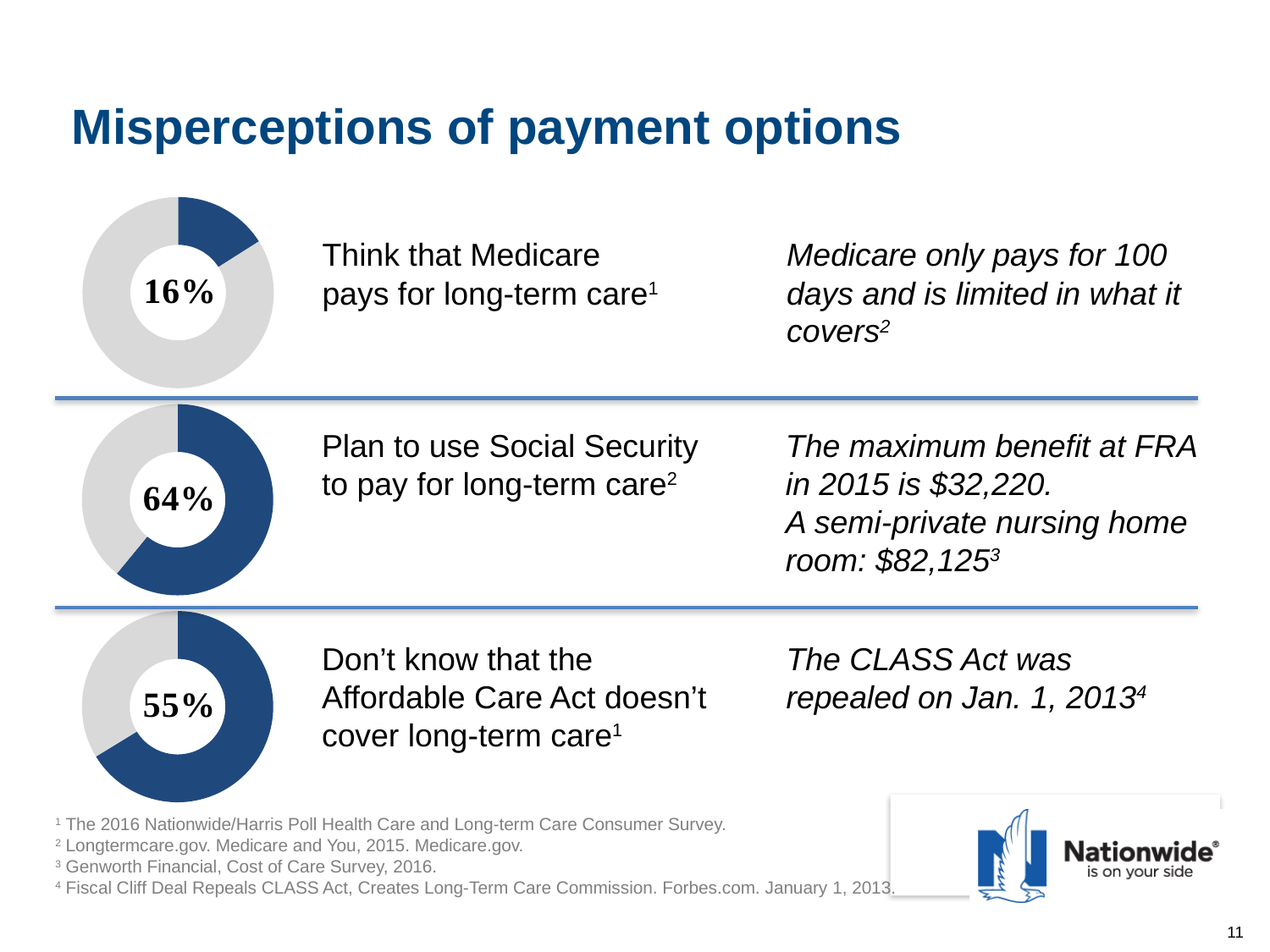
What is the difference between the percentage in the middle donut chart (Social Security) and the bottom donut chart (Affordable Care Act)? 9 percentage points How many donut charts are shown on the slide? 3 Which of the three donut charts shows the lowest percentage? Think that Medicare pays for long-term care (16%) In the middle donut chart, what percentage plan to use Social Security to pay for long-term care? 64% Which is larger: the percentage who plan to use Social Security to pay for long-term care or the percentage who don't know the Affordable Care Act doesn't cover long-term care? Plan to use Social Security (64%) In the bottom donut chart, what percentage don't know that the Affordable Care Act doesn't cover long-term care? 55% In the top donut chart, what percentage think that Medicare pays for long-term care? 16% Which of the three donut charts shows the highest percentage? Plan to use Social Security to pay for long-term care (64%) In the top donut chart, what share of the ring is grey (not highlighted)? 84% What kind of chart is used to show the percentages on this slide? Donut (pie) chart What colour is used for the highlighted percentage slice in each donut chart? Dark blue What is the difference between the percentage in the middle donut chart (Social Security) and the top donut chart (Medicare)? 48 percentage points